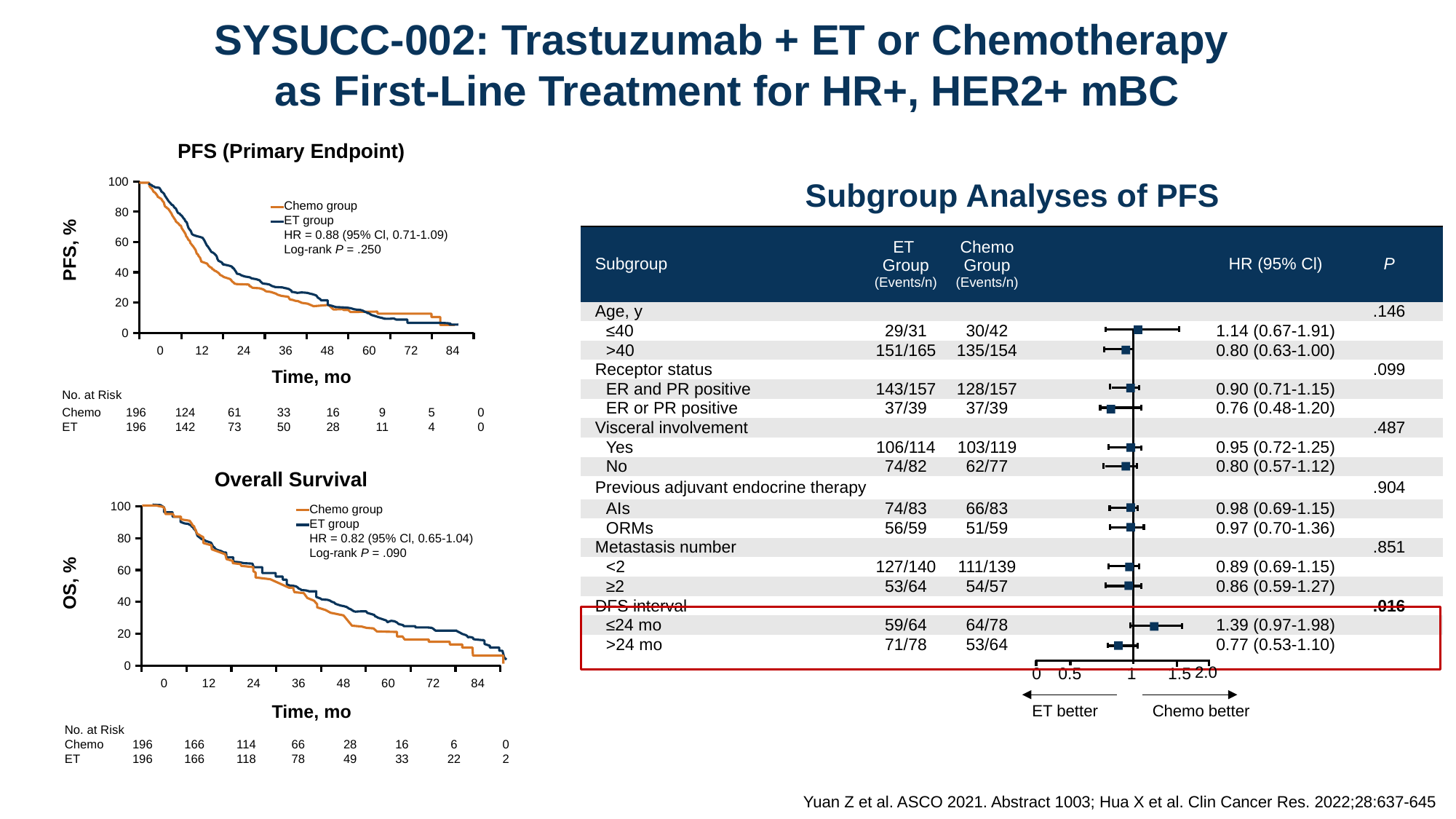
How many series does the legend of the Overall Survival chart list? 2 On the PFS (Primary Endpoint) chart, how many ET patients were at risk at 36 months? 50 In the Subgroup Analyses of PFS forest plot, what is the HR (95% CI) for patients aged ≤40? 1.14 (0.67-1.91) On the PFS (Primary Endpoint) chart, what hazard ratio is printed for ET versus chemo? HR = 0.88 (95% CI, 0.71-1.09) In the Subgroup Analyses of PFS forest plot, which subgroup has the highest hazard ratio? DFS interval ≤24 mo (1.39) On the PFS (Primary Endpoint) chart, which group had more patients at risk at 12 months, Chemo or ET? ET On the PFS (Primary Endpoint) chart, what is the difference between the number of ET and Chemo patients at risk at 36 months? 17 On the Overall Survival chart, how many Chemo patients were at risk at 24 months? 114 On the Overall Survival chart, do the curves rise or fall as time increases? Fall On the Overall Survival chart, what is the log-rank P value shown? .090 In the Subgroup Analyses of PFS forest plot, what is the P value for the DFS interval subgroup? .016 What kind of chart is the PFS (Primary Endpoint) chart? Line chart